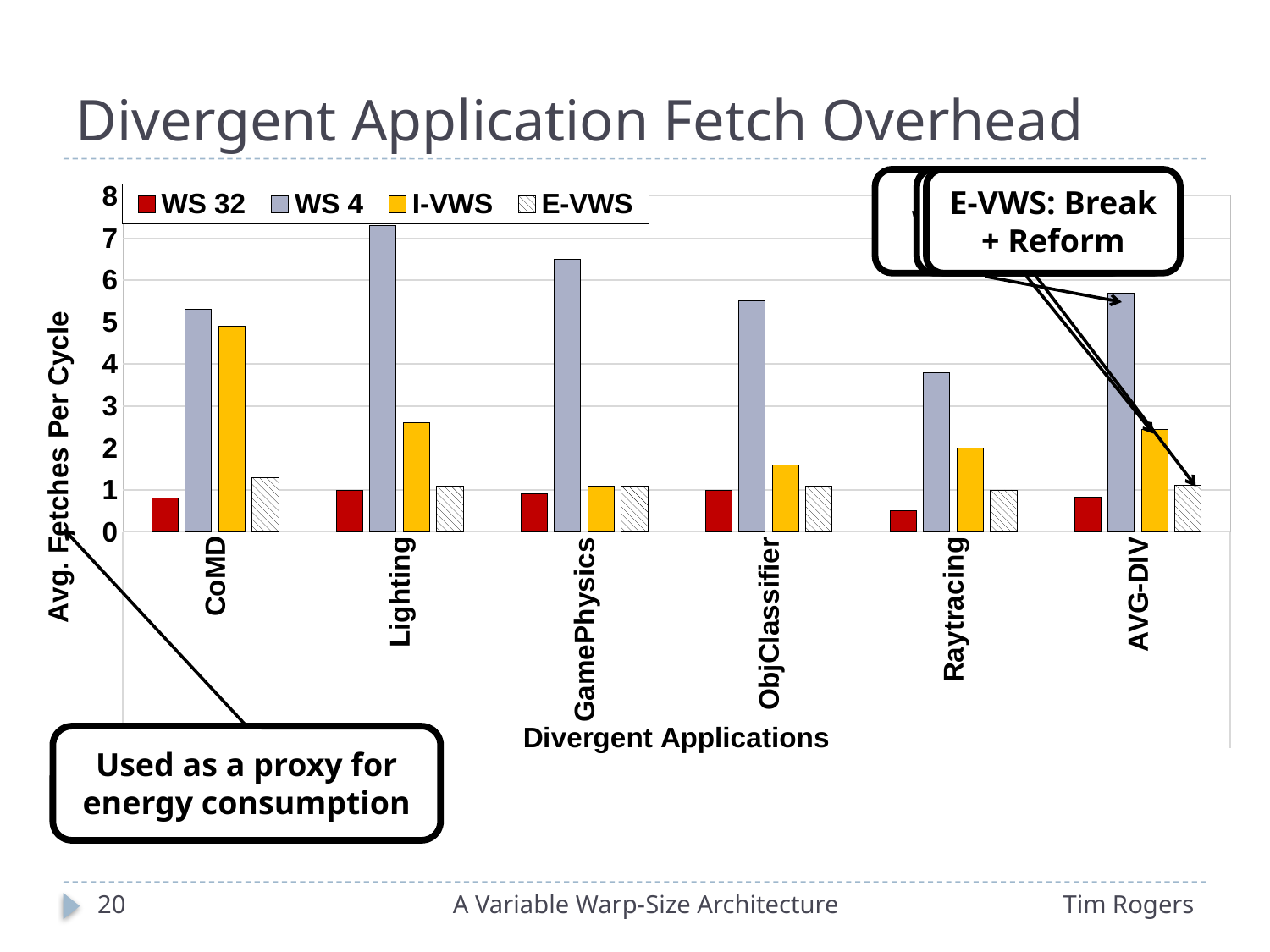
What is the label of the y axis? Avg. Fetches Per Cycle Is the WS 4 value for Raytracing greater or less than 4? less Is the WS 4 value for Lighting greater or less than 7? greater How many application categories are shown on the x axis? 6 What kind of chart is shown on the slide? bar chart Which application has the highest WS 4 value? Lighting Is the E-VWS value for AVG-DIV greater or less than 2? less For CoMD, which is larger: the WS 4 value or the I-VWS value? WS 4 For Raytracing, which is larger: the I-VWS value or the WS 32 value? I-VWS Which application has the lowest WS 4 value? Raytracing How many series does the legend list? 4